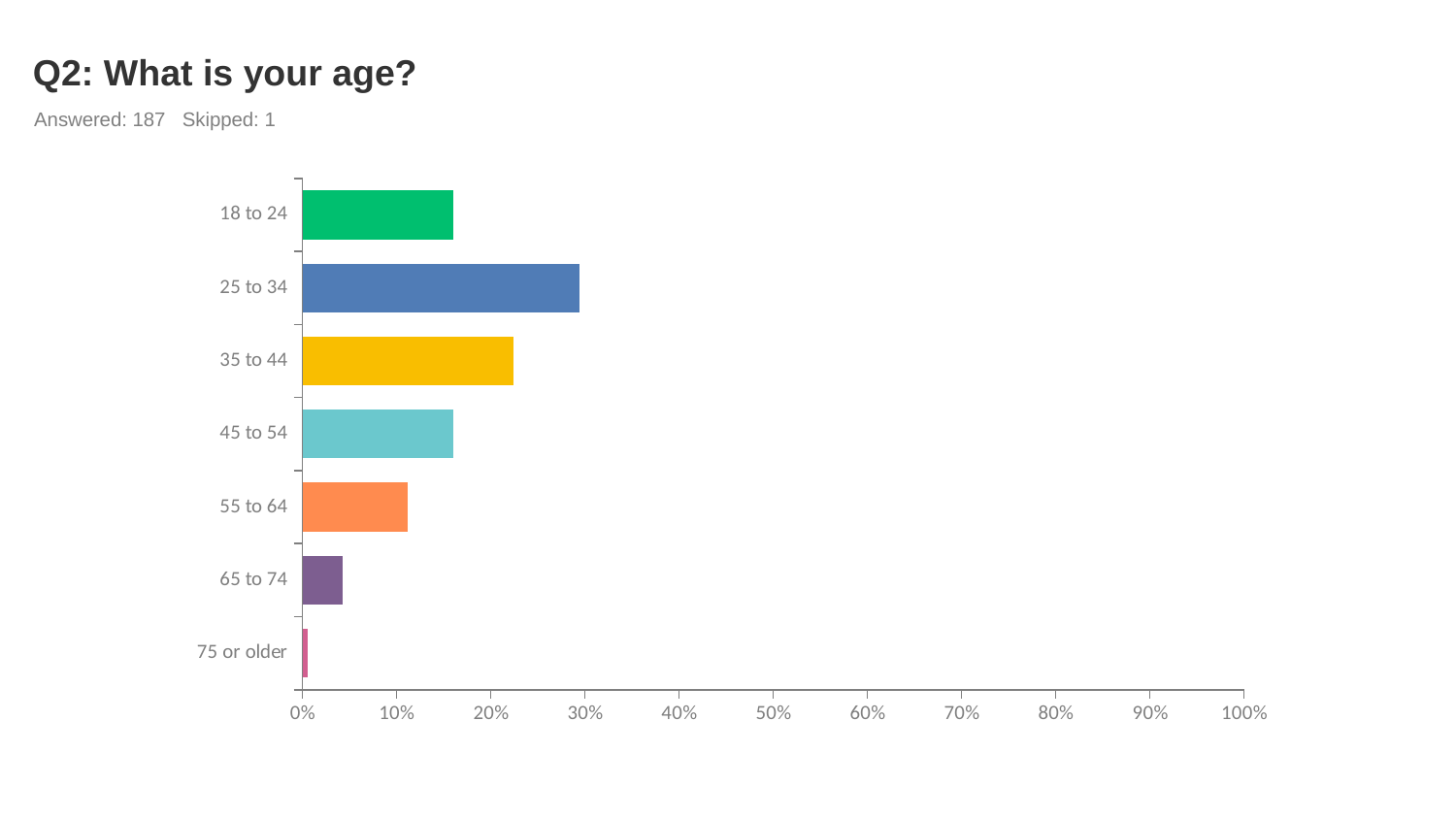
Which is larger, the value for 18 to 24 or the value for 25 to 34? 25 to 34 What kind of chart is shown on the slide? bar chart Is the value for 65 to 74 greater or less than 10%? less Which age category has the lowest value? 75 or older Which age category has the highest value? 25 to 34 Do the values rise or fall going from the 25 to 34 category down to the 75 or older category? fall Is the value for 25 to 34 greater or less than 20%? greater Is the value for 55 to 64 greater or less than 10%? greater What is the title of the chart? Q2: What is your age? How many age categories are plotted in the chart? 7 Which is larger, the value for 35 to 44 or the value for 55 to 64? 35 to 44